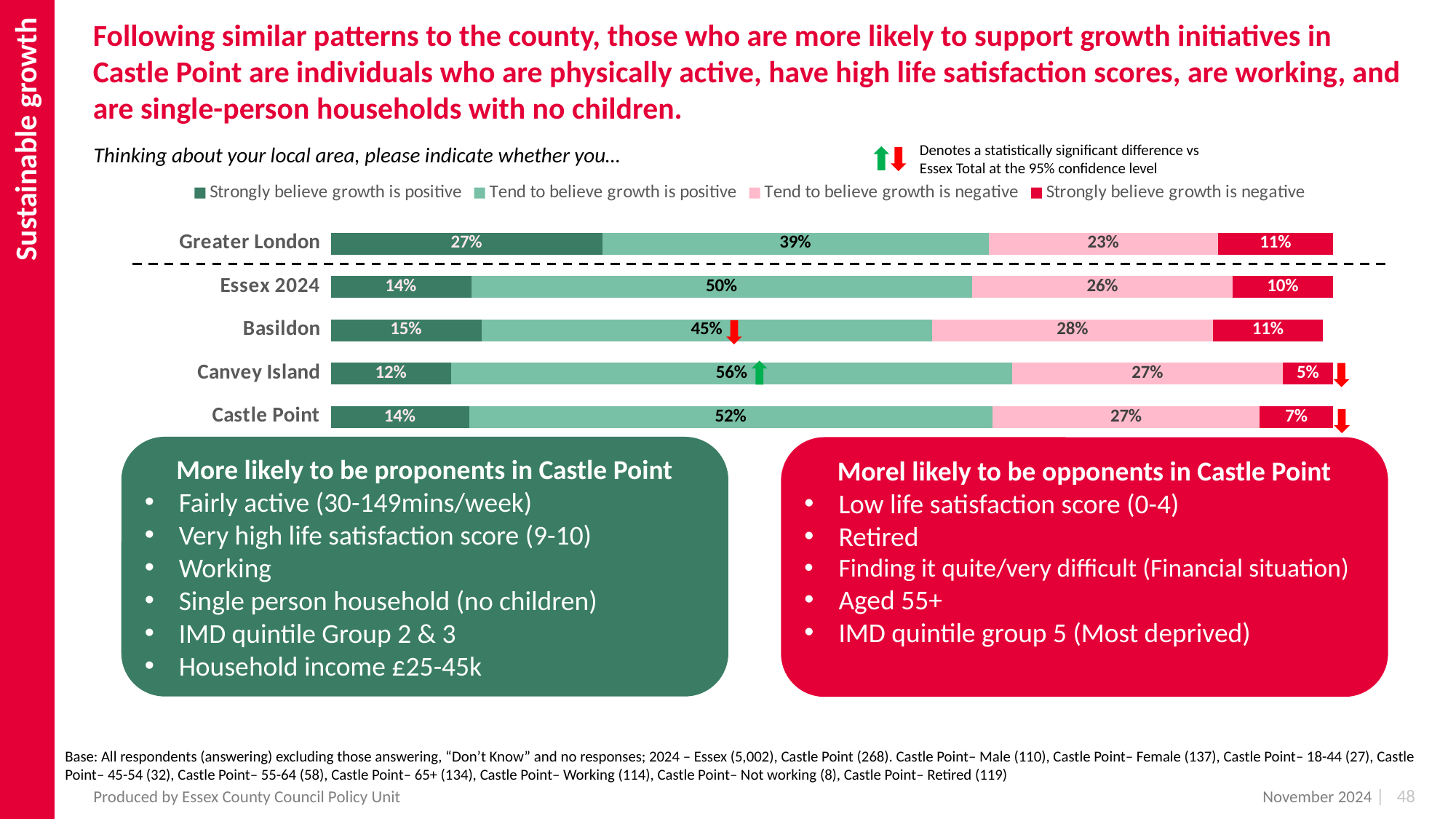
How many series does the chart legend list? 4 Which has a larger share of respondents who strongly believe growth is positive, Greater London or Essex 2024? Greater London What is the combined share of Castle Point respondents who strongly or tend to believe growth is positive? 66% How many percentage points higher is the 'Tend to believe growth is positive' share for Castle Point than for Essex 2024? 2 percentage points Which area has the highest share of respondents who tend to believe growth is positive? Canvey Island How many areas are shown in the chart? 5 What type of chart is shown on the slide? Stacked bar chart Which area has the lowest share of respondents who strongly believe growth is negative? Canvey Island What percentage of Castle Point respondents tend to believe growth is positive? 52% What percentage of Basildon respondents tend to believe growth is negative? 28% What percentage of Greater London respondents strongly believe growth is positive? 27% What colour represents 'Strongly believe growth is negative' in the chart? Red